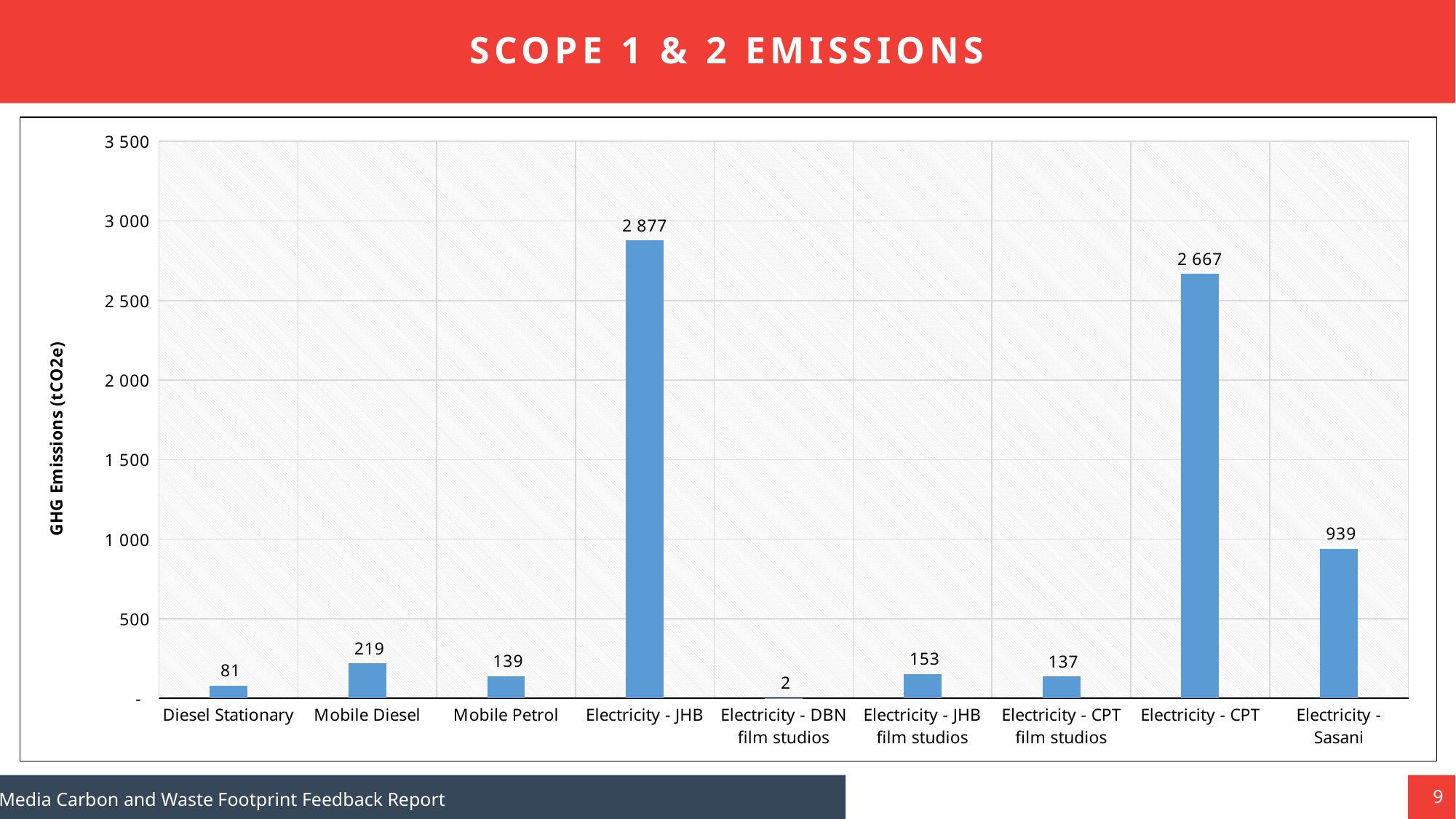
Which category has the lowest GHG emissions? Electricity - DBN film studios How many categories are shown on the x axis? 9 What kind of chart is shown on the slide? Bar chart Which has higher GHG emissions, Mobile Diesel or Mobile Petrol? Mobile Diesel What is the difference in GHG emissions between Electricity - JHB and Electricity - CPT? 210 Which category has the highest GHG emissions? Electricity - JHB What is the GHG emissions value for Electricity - JHB? 2 877 Is the value for Electricity - Sasani greater or less than 1 000? less What is the GHG emissions value for Electricity - DBN film studios? 2 What is the label of the vertical axis? GHG Emissions (tCO2e) What is the GHG emissions value for Mobile Diesel? 219 What is the GHG emissions value for Electricity - Sasani? 939